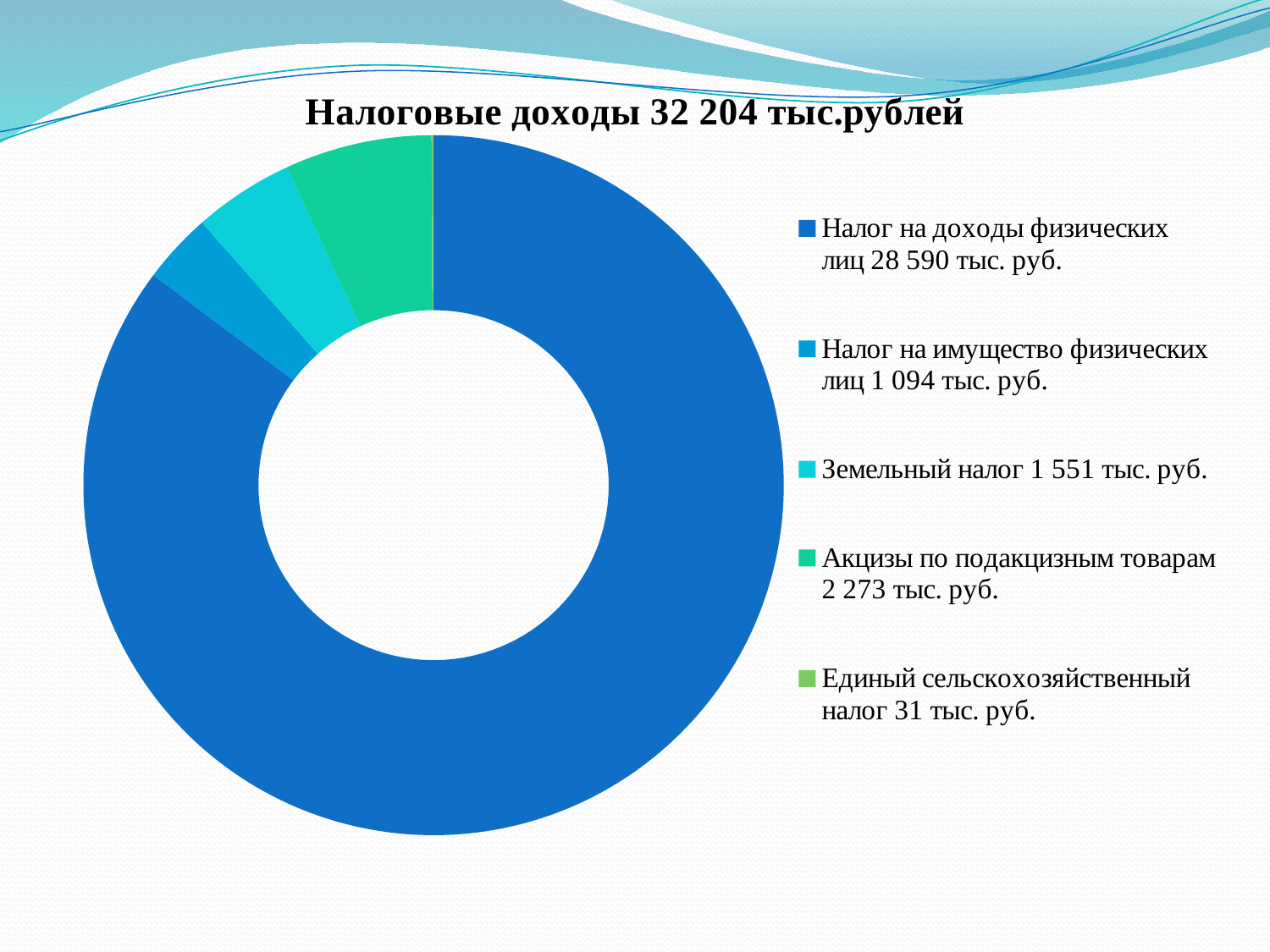
What is the value for Земельный налог? 1 551 тыс. руб. Which is larger: Акцизы по подакцизным товарам or Земельный налог? Акцизы по подакцизным товарам What is the difference between Акцизы по подакцизным товарам and Земельный налог? 722 тыс. руб. What is the value for Акцизы по подакцизным товарам? 2 273 тыс. руб. How many categories does the chart show? 5 What kind of chart is shown on the slide? Doughnut (pie) chart Which category has the largest share of the chart? Налог на доходы физических лиц What is the value for Налог на имущество физических лиц? 1 094 тыс. руб. Which category has the smallest value? Единый сельскохозяйственный налог What is the title of the chart? Налоговые доходы 32 204 тыс.рублей What is the value for Налог на доходы физических лиц? 28 590 тыс. руб. What is the value for Единый сельскохозяйственный налог? 31 тыс. руб.